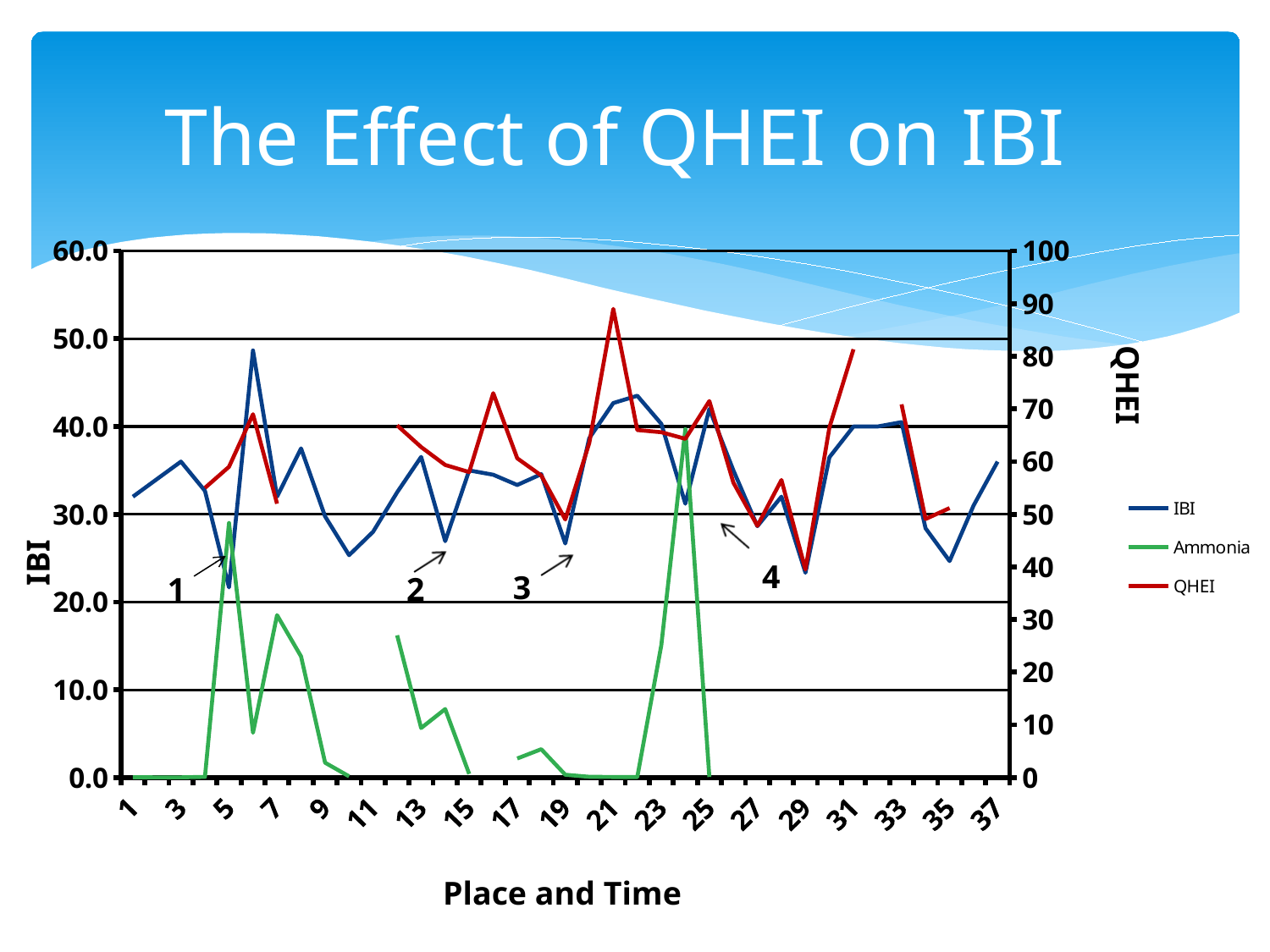
What is the title of the chart? The Effect of QHEI on IBI Does the IBI line rise or fall from x = 33 to x = 35? fall How many series does the legend list? 3 Does the QHEI line rise or fall from x = 21 to x = 22? fall Does the IBI line rise or fall from x = 5 to x = 6? rise Is the QHEI value at x = 29 greater or less than 50 on the right axis? less What is the label of the x axis? Place and Time Is the IBI value at x = 29 greater or less than 30.0? less Is the IBI value at x = 6 greater or less than 40.0? greater What kind of chart is shown on the slide? line chart